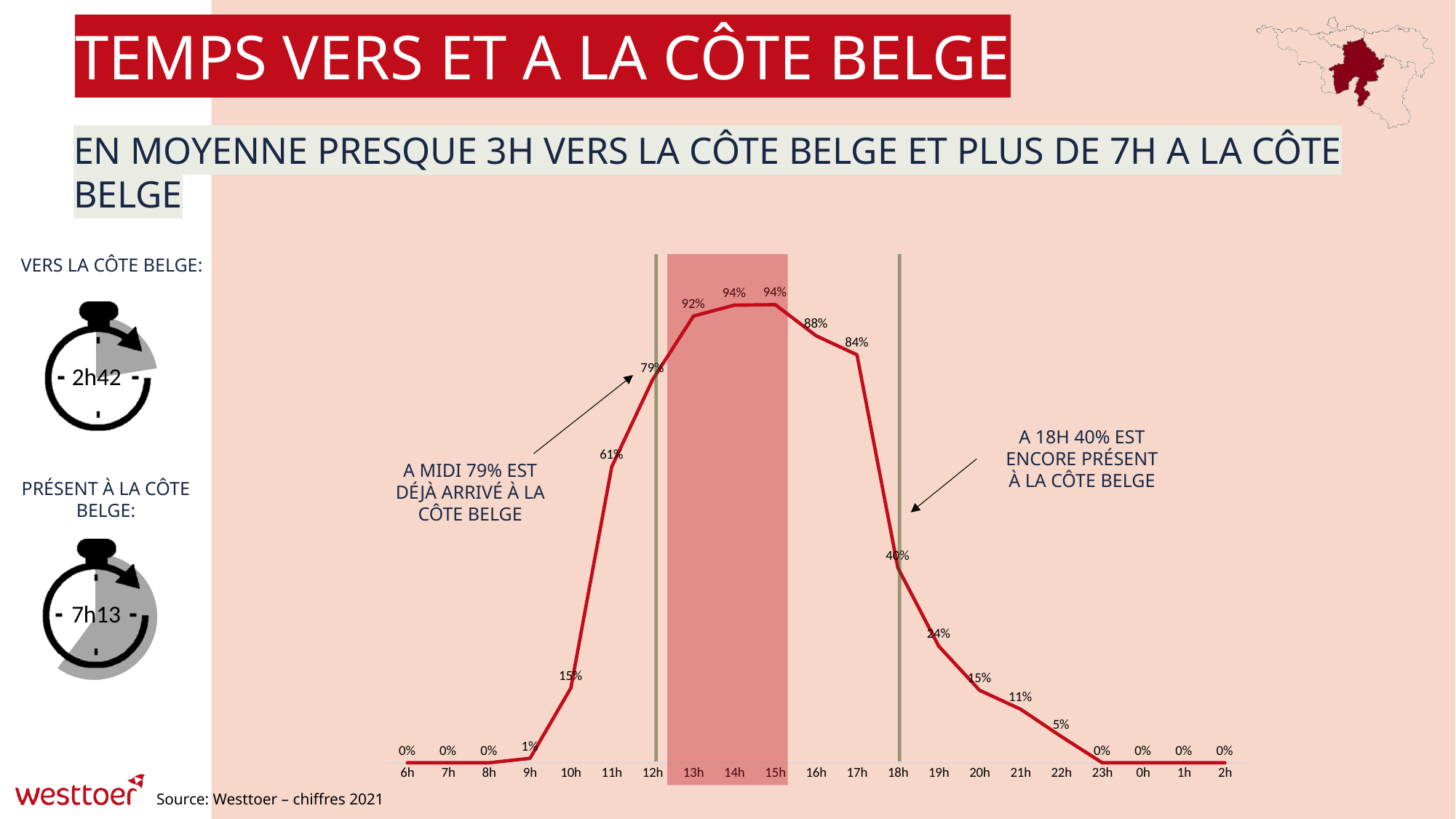
What is the difference between the values at 13h and 12h? 13% What is the value shown at 18h? 40% How many hourly points are plotted along the x axis? 21 What is the highest value plotted on the chart? 94% What is the value shown at 11h? 61% What is the value shown at 22h? 5% What type of chart is shown on the slide? line chart Do the values rise or fall between 15h and 23h? fall What is the value shown at 12h? 79% What is the difference between the values at 17h and 18h? 44% Which hours are covered by the shaded red band on the chart? 13h, 14h and 15h Which is larger, the value at 16h or the value at 19h? 16h